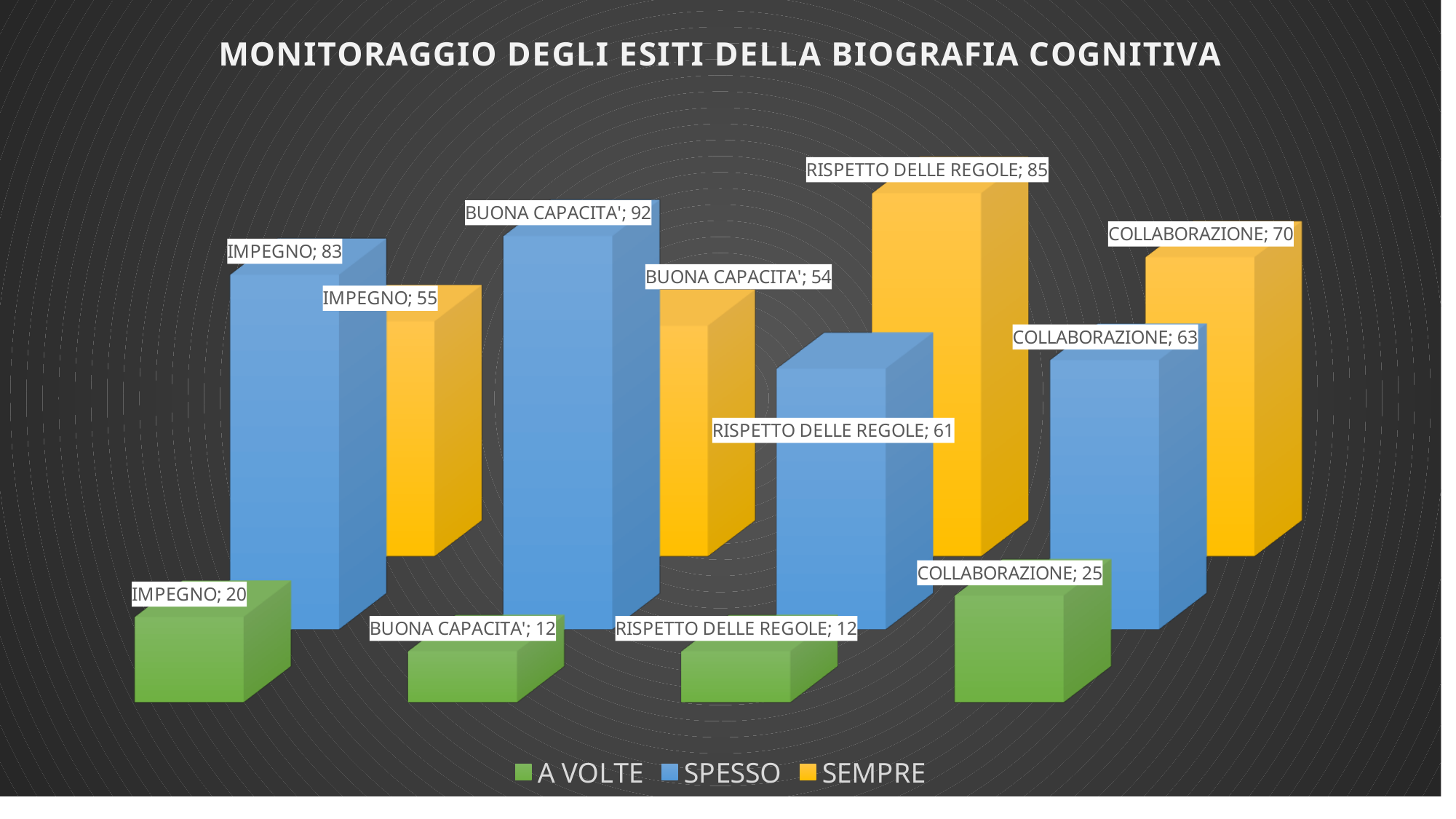
Which category has the lowest SEMPRE value? BUONA CAPACITA' What kind of chart is shown on the slide? Bar chart Which is larger for COLLABORAZIONE: the SPESSO value or the SEMPRE value? SEMPRE What is the title of the chart? MONITORAGGIO DEGLI ESITI DELLA BIOGRAFIA COGNITIVA How many series does the legend list? 3 How many categories are shown in the chart? 4 Which category has the highest SPESSO value? BUONA CAPACITA' What is the SPESSO value for BUONA CAPACITA'? 92 What is the SEMPRE value for RISPETTO DELLE REGOLE? 85 What is the A VOLTE value for COLLABORAZIONE? 25 What is the difference between the SPESSO value for IMPEGNO and the SEMPRE value for IMPEGNO? 28 What is the SEMPRE value for IMPEGNO? 55